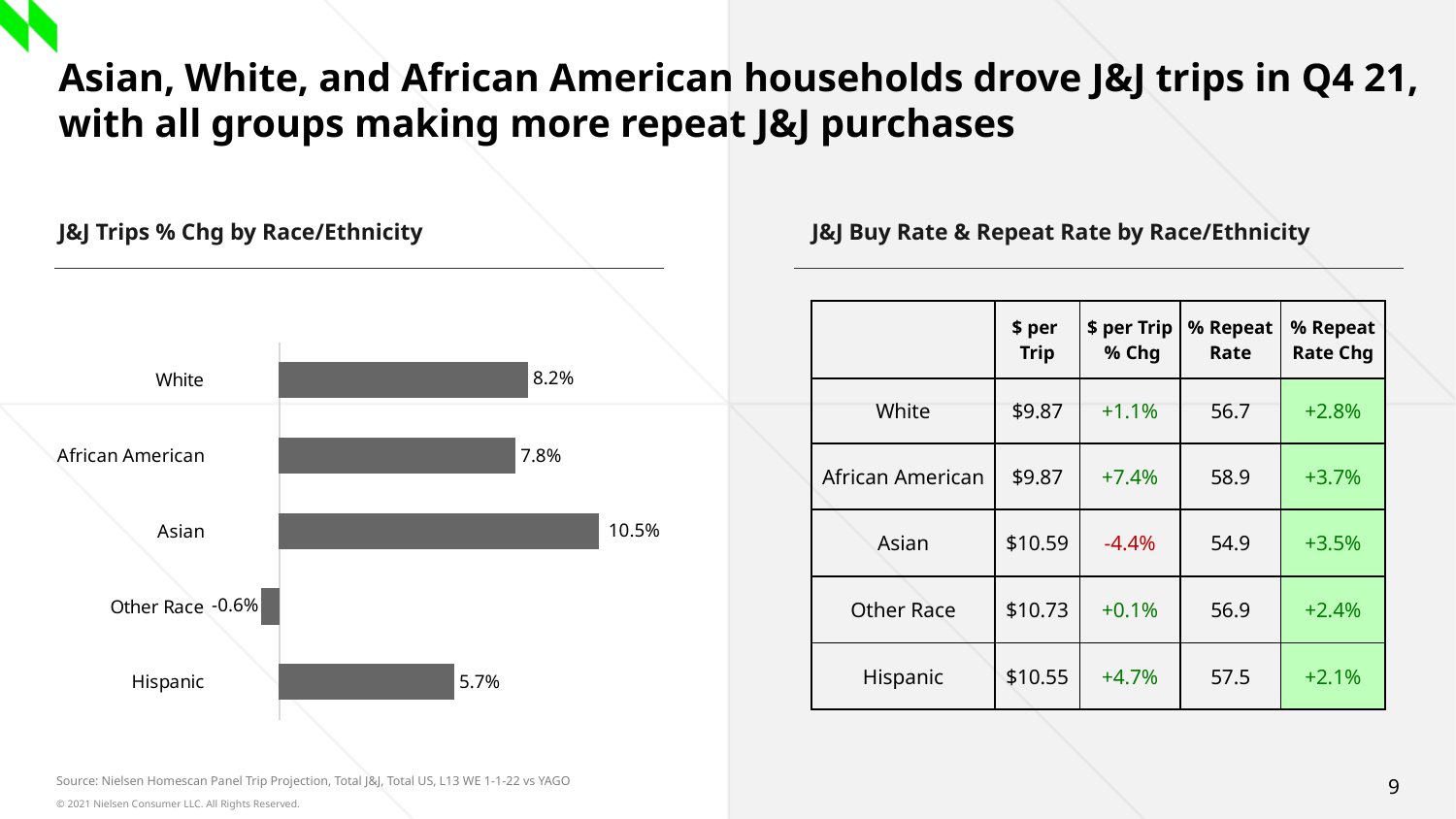
Which race/ethnicity group has the lowest J&J trips % change? Other Race How many race/ethnicity groups are shown in the J&J Trips % Chg chart? 5 What is the difference in J&J trips % change between Asian and White households? 2.3 percentage points What is the J&J trips % change for Asian households? 10.5% What type of chart is used to show J&J Trips % Chg by Race/Ethnicity? Bar chart What is the J&J trips % change for White households? 8.2% What is the J&J trips % change for Other Race households? -0.6% Which race/ethnicity group has the highest J&J trips % change? Asian What is the J&J trips % change for Hispanic households? 5.7% What is the title of the chart on the left side of the slide? J&J Trips % Chg by Race/Ethnicity What is the difference in J&J trips % change between Hispanic and Other Race households? 6.3 percentage points Which has a larger J&J trips % change, White or African American households? White